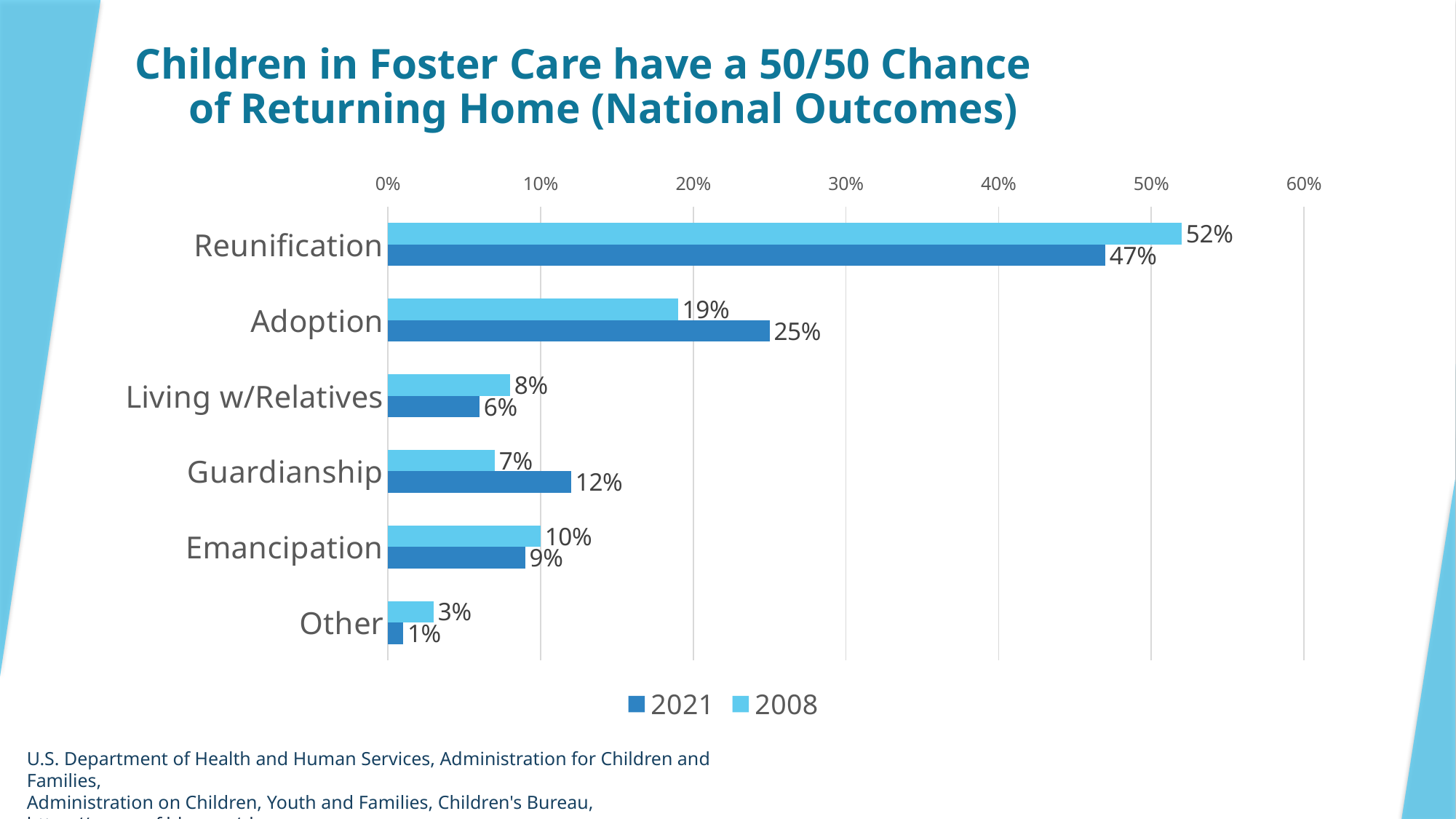
Which category has the highest 2008 value? Reunification How many categories are shown on the chart? 6 Which is larger for Guardianship, the 2021 value or the 2008 value? 2021 What is the 2021 value for Guardianship? 12% What is the difference between the 2021 and 2008 values for Adoption? 6% Is the 2021 value for Adoption greater or less than 20%? greater How many series does the legend list? 2 What is the 2008 value for Adoption? 19% What is the 2021 value for Reunification? 47% What kind of chart is shown on the slide? Bar chart What is the difference between the 2008 and 2021 values for Reunification? 5% Which category has the lowest 2021 value? Other